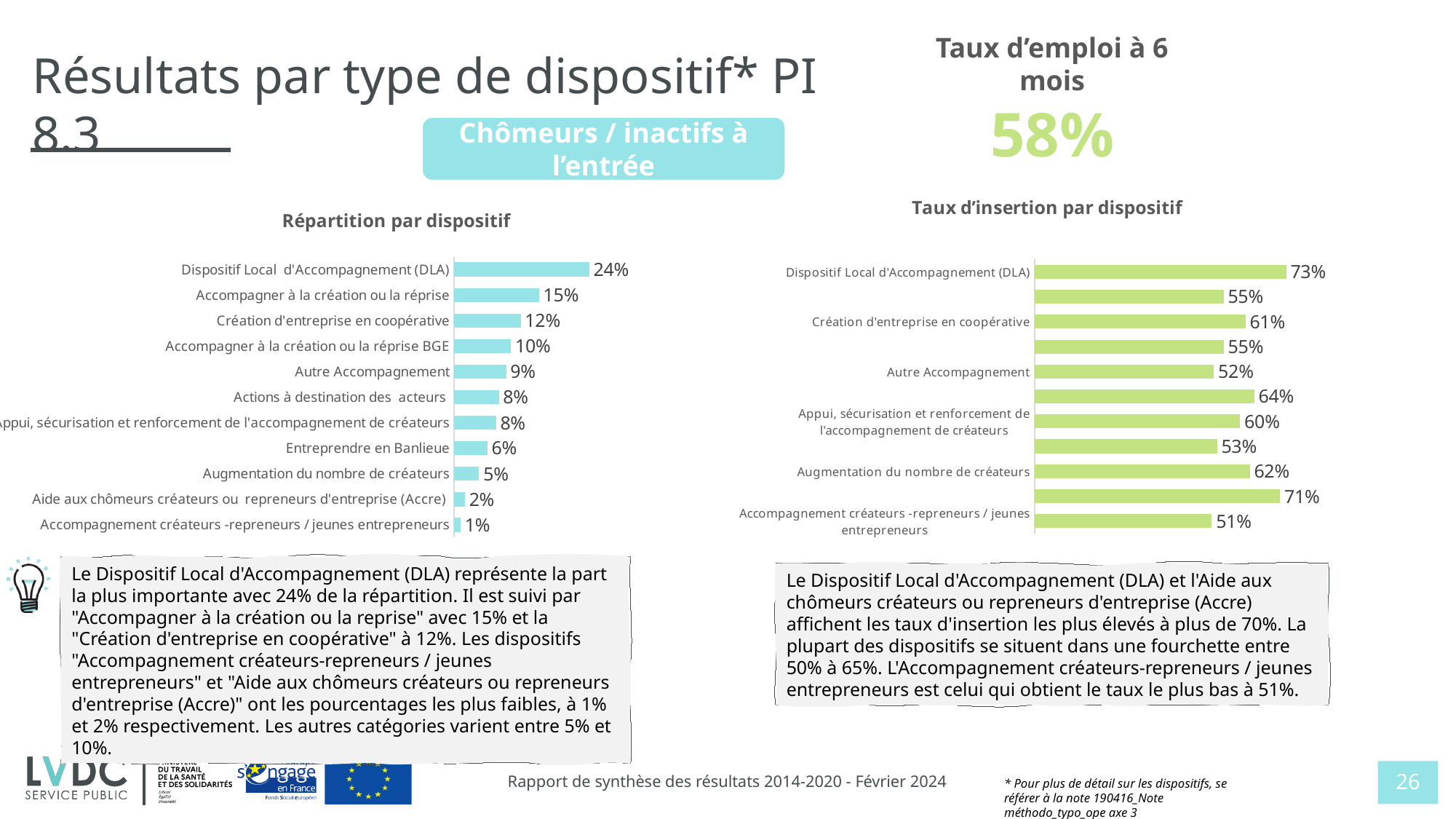
What colour are the bars in the 'Répartition par dispositif' chart? Light blue What kind of chart is 'Taux d'insertion par dispositif'? Bar chart How many categories are shown in the 'Répartition par dispositif' chart? 11 In the 'Taux d'insertion par dispositif' chart, what is the value for Dispositif Local d'Accompagnement (DLA)? 73% In the 'Répartition par dispositif' chart, what is the difference between Dispositif Local d'Accompagnement (DLA) and Accompagner à la création ou la réprise? 9% In the 'Taux d'insertion par dispositif' chart, what is the value for Augmentation du nombre de créateurs? 62% In the 'Répartition par dispositif' chart, what is the value for Dispositif Local d'Accompagnement (DLA)? 24% In the 'Répartition par dispositif' chart, which is larger: Entreprendre en Banlieue or Augmentation du nombre de créateurs? Entreprendre en Banlieue In the 'Taux d'insertion par dispositif' chart, what is the difference between Création d'entreprise en coopérative and Autre Accompagnement? 9% In the 'Taux d'insertion par dispositif' chart, which category has the highest value? Dispositif Local d'Accompagnement (DLA) In the 'Répartition par dispositif' chart, which category has the lowest value? Accompagnement créateurs -repreneurs / jeunes entrepreneurs In the 'Répartition par dispositif' chart, what is the value for Création d'entreprise en coopérative? 12%